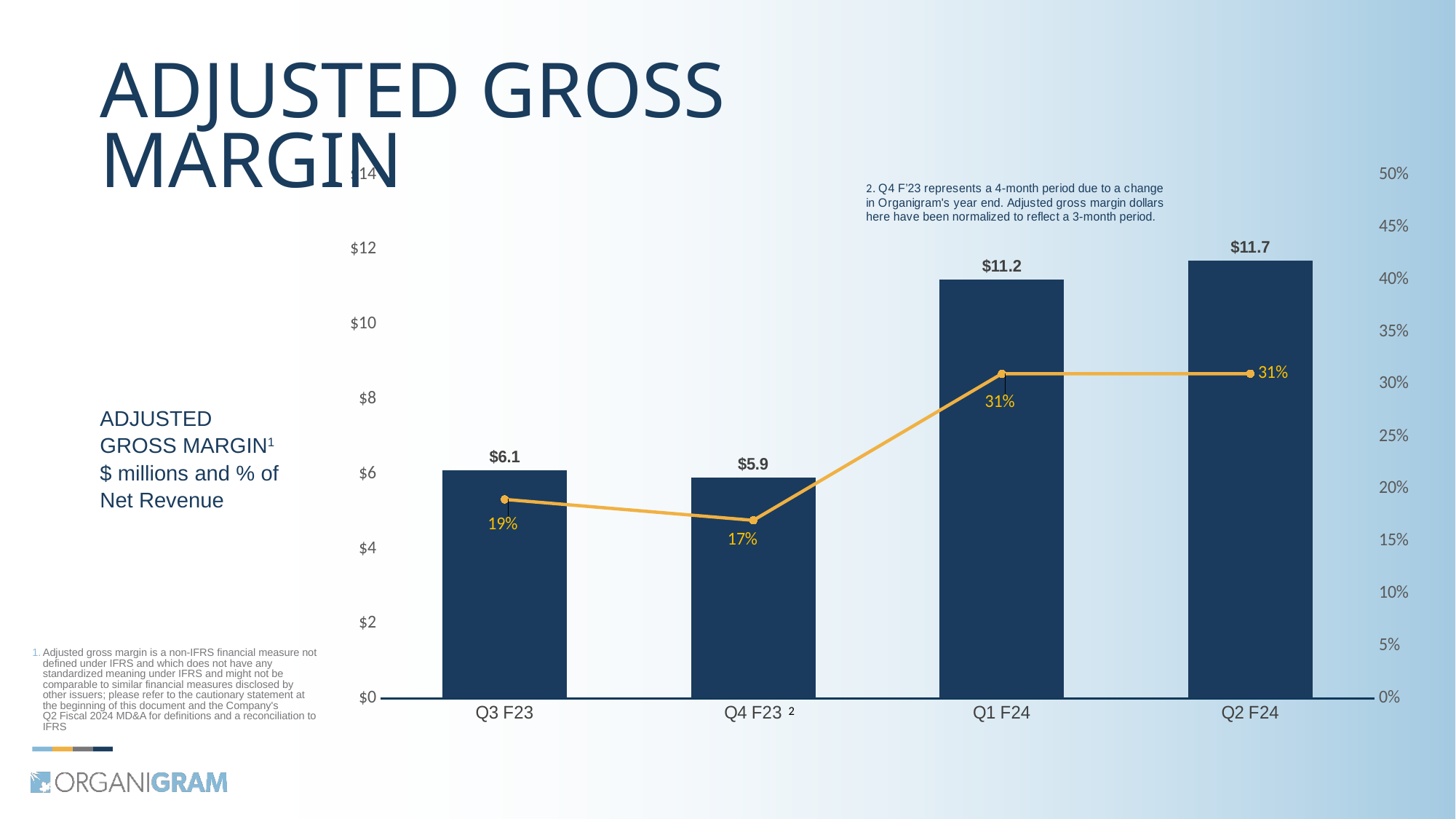
Does the adjusted gross margin in $ millions rise or fall from Q4 F23 to Q2 F24? Rise How many quarters are shown on the x axis of the chart? 4 What is the difference in adjusted gross margin dollars between Q2 F24 and Q1 F24? $0.5 Which quarter has a larger adjusted gross margin in $ millions, Q3 F23 or Q4 F23? Q3 F23 Which quarter has the lowest adjusted gross margin as a % of net revenue? Q4 F23 What is the adjusted gross margin in $ millions for Q3 F23? $6.1 Which quarter has the highest adjusted gross margin in $ millions? Q2 F24 What is the difference in adjusted gross margin percentage between Q1 F24 and Q3 F23? 12 percentage points What kind of chart is used to show the adjusted gross margin in $ millions? Bar chart What is the adjusted gross margin in $ millions for Q1 F24? $11.2 What is the adjusted gross margin as a % of net revenue for Q4 F23? 17% What colour is the line showing adjusted gross margin as a % of net revenue? Yellow/orange